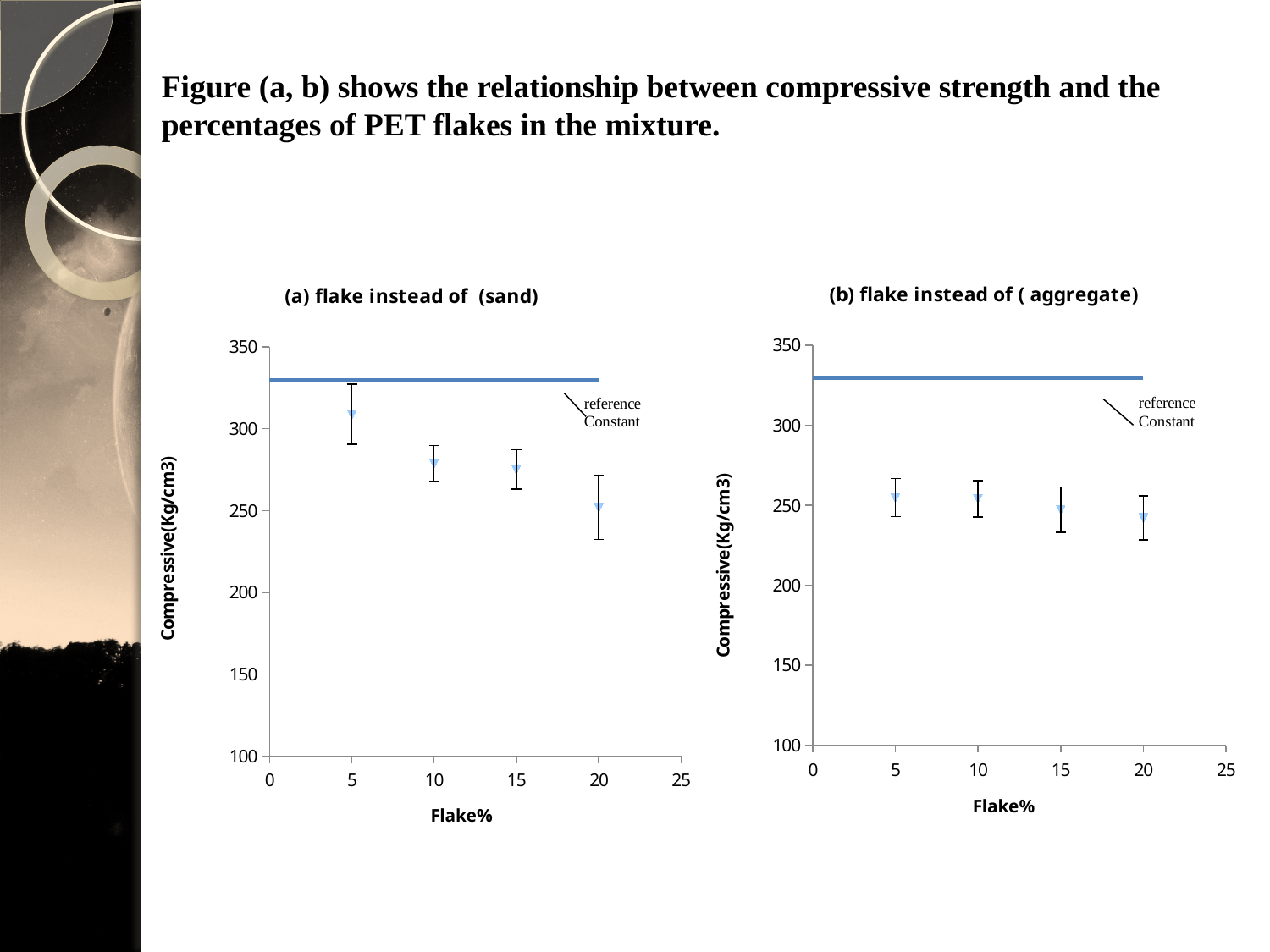
What is the label of the y axis in the chart titled "(b) flake instead of ( aggregate)"? Compressive(Kg/cm3) In the chart titled "(b) flake instead of ( aggregate)", is the compressive strength at 10% flake greater or less than 300? less In the chart titled "(a) flake instead of (sand)", at which Flake% is the compressive strength lowest? 20 Which is larger: the compressive strength at 5% flake in the chart titled "(a) flake instead of (sand)" or at 5% flake in the chart titled "(b) flake instead of ( aggregate)"? (a) flake instead of (sand) In the chart titled "(a) flake instead of (sand)", how many data points are plotted (excluding the reference line)? 4 In the chart titled "(a) flake instead of (sand)", at which Flake% is the compressive strength highest? 5 In the chart titled "(b) flake instead of ( aggregate)", do the compressive strength values rise or fall as Flake% increases? fall In the chart titled "(a) flake instead of (sand)", do the compressive strength values rise or fall as Flake% increases? fall What kind of chart is the chart titled "(a) flake instead of (sand)"? scatter chart In the chart titled "(a) flake instead of (sand)", is the compressive strength at 5% flake greater or less than 300? greater In the chart titled "(a) flake instead of (sand)", is the compressive strength at 20% flake greater or less than 300? less In the chart titled "(b) flake instead of ( aggregate)", how many data points are plotted (excluding the reference line)? 4